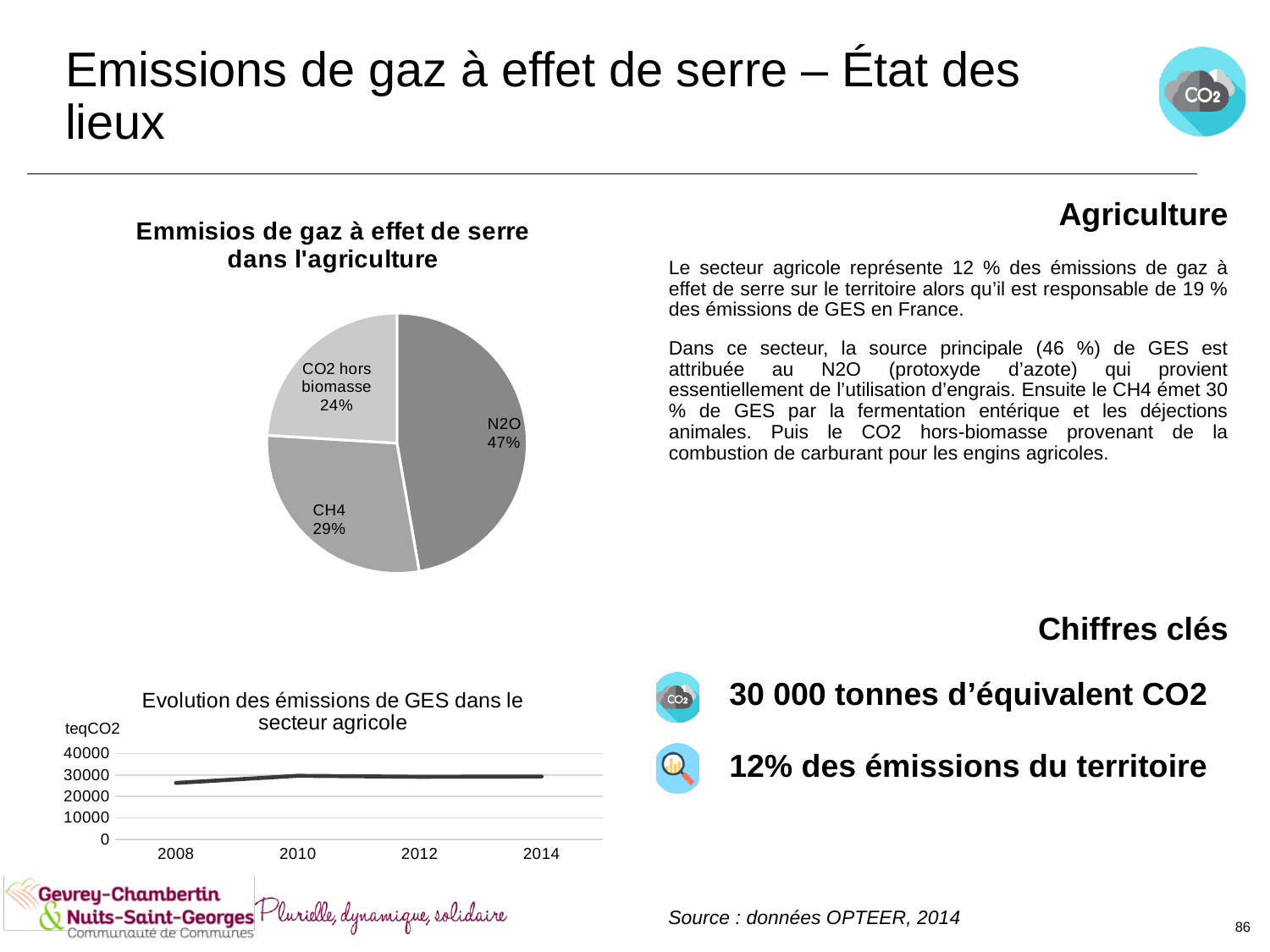
What unit is shown on the y axis of the chart 'Evolution des émissions de GES dans le secteur agricole'? teqCO2 In the pie chart 'Emmisios de gaz à effet de serre dans l'agriculture', which gas has the smallest share? CO2 hors biomasse In the pie chart 'Emmisios de gaz à effet de serre dans l'agriculture', what share does CO2 hors biomasse represent? 24% How many slices does the pie chart 'Emmisios de gaz à effet de serre dans l'agriculture' have? 3 In the pie chart 'Emmisios de gaz à effet de serre dans l'agriculture', which gas has the largest share? N2O What type of chart is 'Evolution des émissions de GES dans le secteur agricole'? line chart In the pie chart 'Emmisios de gaz à effet de serre dans l'agriculture', what share does CH4 represent? 29% In the chart 'Evolution des émissions de GES dans le secteur agricole', is the value for 2008 greater or less than 20000? greater In the pie chart 'Emmisios de gaz à effet de serre dans l'agriculture', what is the difference in percentage points between N2O and CH4? 18 In the pie chart 'Emmisios de gaz à effet de serre dans l'agriculture', what share does N2O represent? 47% In the pie chart 'Emmisios de gaz à effet de serre dans l'agriculture', which is larger, the share of CH4 or the share of CO2 hors biomasse? CH4 In the chart 'Evolution des émissions de GES dans le secteur agricole', is the value for 2014 greater or less than 40000? less